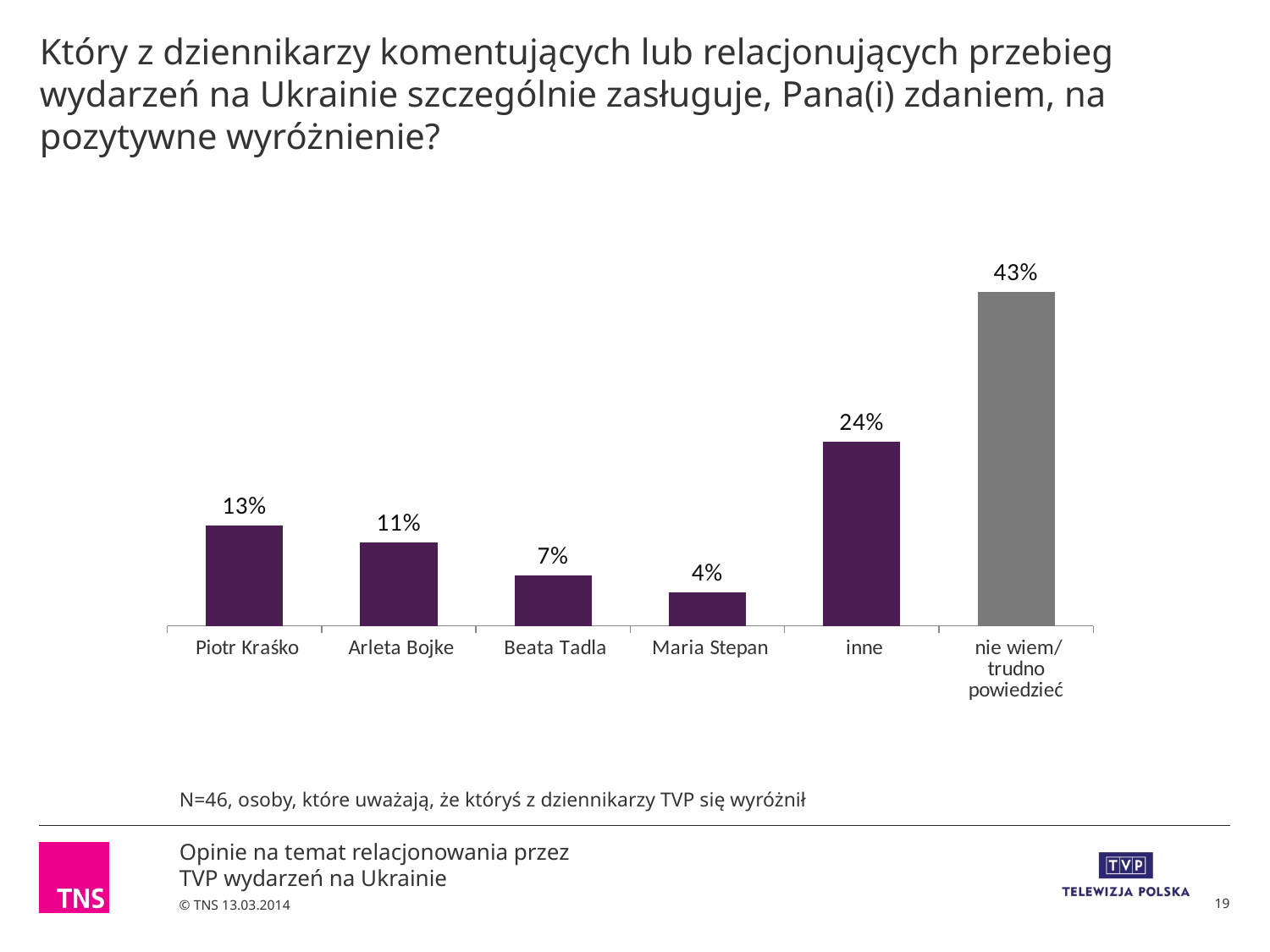
What percentage is shown for Maria Stepan? 4% What percentage is shown for Piotr Kraśko? 13% Which category has the lowest value? Maria Stepan What percentage is shown for the 'inne' category? 24% Which category has the highest value? nie wiem/ trudno powiedzieć What percentage is shown for Arleta Bojke? 11% Which is larger, the value for Piotr Kraśko or the value for Arleta Bojke? Piotr Kraśko What is the difference between the values for 'nie wiem/ trudno powiedzieć' and 'inne'? 19% What percentage is shown for Beata Tadla? 7% How many categories are shown on the chart? 6 What kind of chart is shown on the slide? bar chart Which bar is shown in a different colour (grey) from the others? nie wiem/ trudno powiedzieć